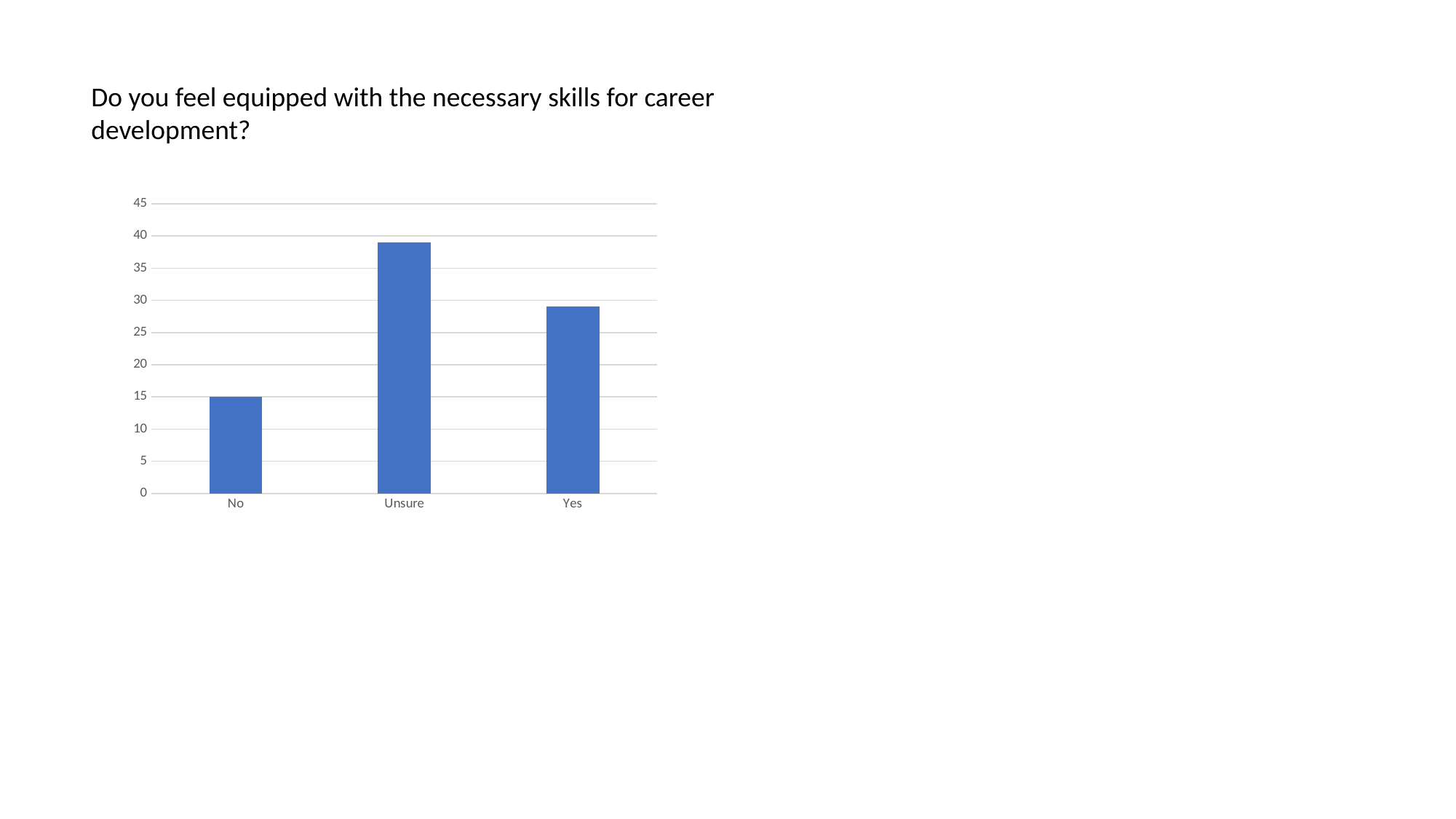
Which category has the highest value? Unsure Is the value for Unsure greater or less than 35? greater Which is larger, the value for No or the value for Yes? Yes Which category has the lowest value? No What is the title of the chart? Do you feel equipped with the necessary skills for career development? What is the value for No? 15 Is the value for Yes greater or less than 25? greater What kind of chart is shown on the slide? bar chart Which is larger, the value for Unsure or the value for Yes? Unsure How many categories are shown on the x axis? 3